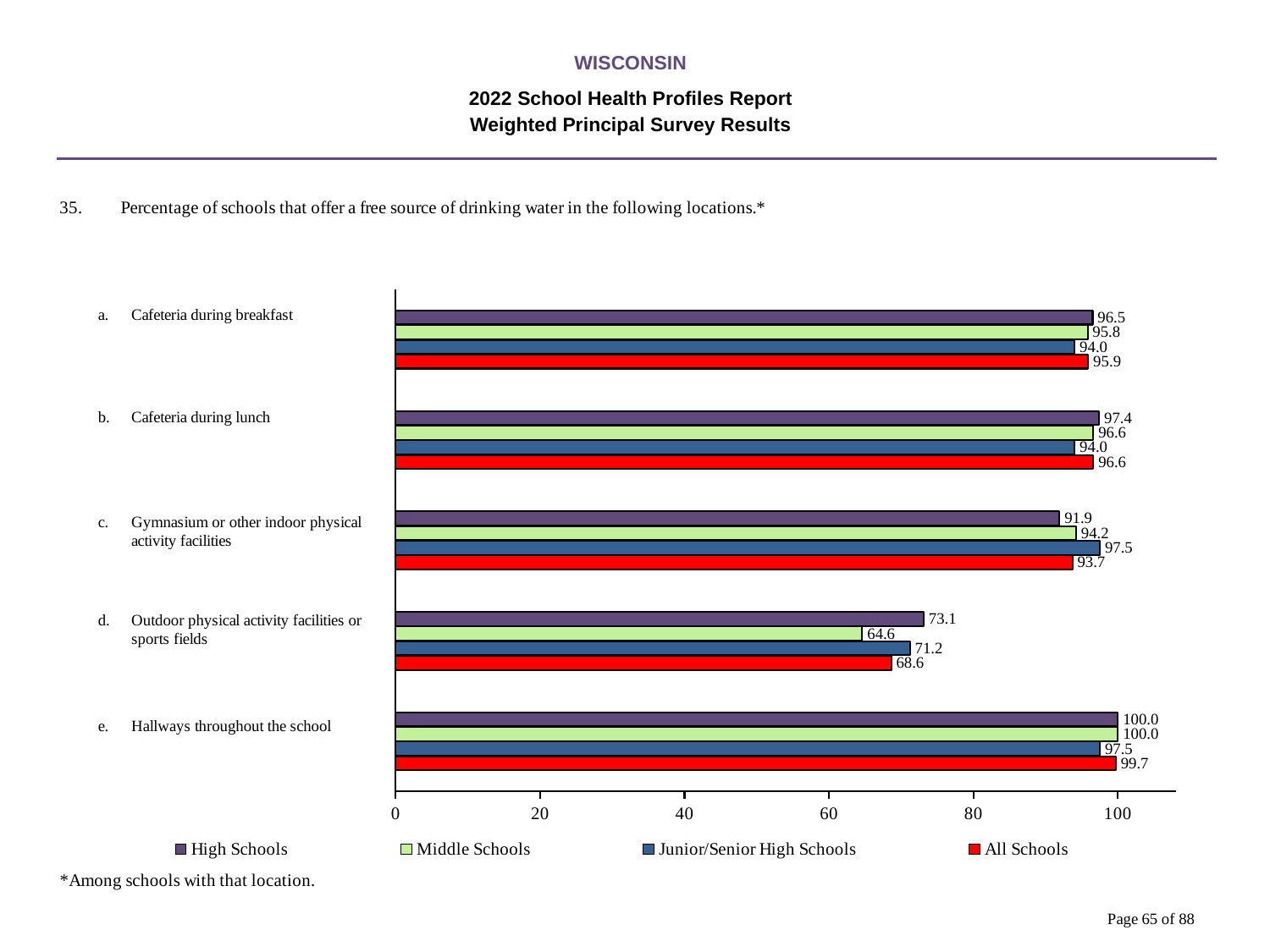
What is the value for Middle Schools for outdoor physical activity facilities or sports fields? 64.6 What kind of chart is shown on the slide? Bar chart What is the difference between the High Schools and Middle Schools values for outdoor physical activity facilities or sports fields? 8.5 How many locations are shown on the chart? 5 What is the value for Junior/Senior High Schools for gymnasium or other indoor physical activity facilities? 97.5 What percentage of High Schools offer a free source of drinking water in the cafeteria during breakfast? 96.5 Which location has the lowest All Schools value? Outdoor physical activity facilities or sports fields For the cafeteria during lunch, which is larger: the High Schools value or the Junior/Senior High Schools value? High Schools What is the All Schools value for hallways throughout the school? 99.7 How many series does the legend list? 4 Which location has the highest High Schools value? Hallways throughout the school Which colour represents All Schools in the legend? Red